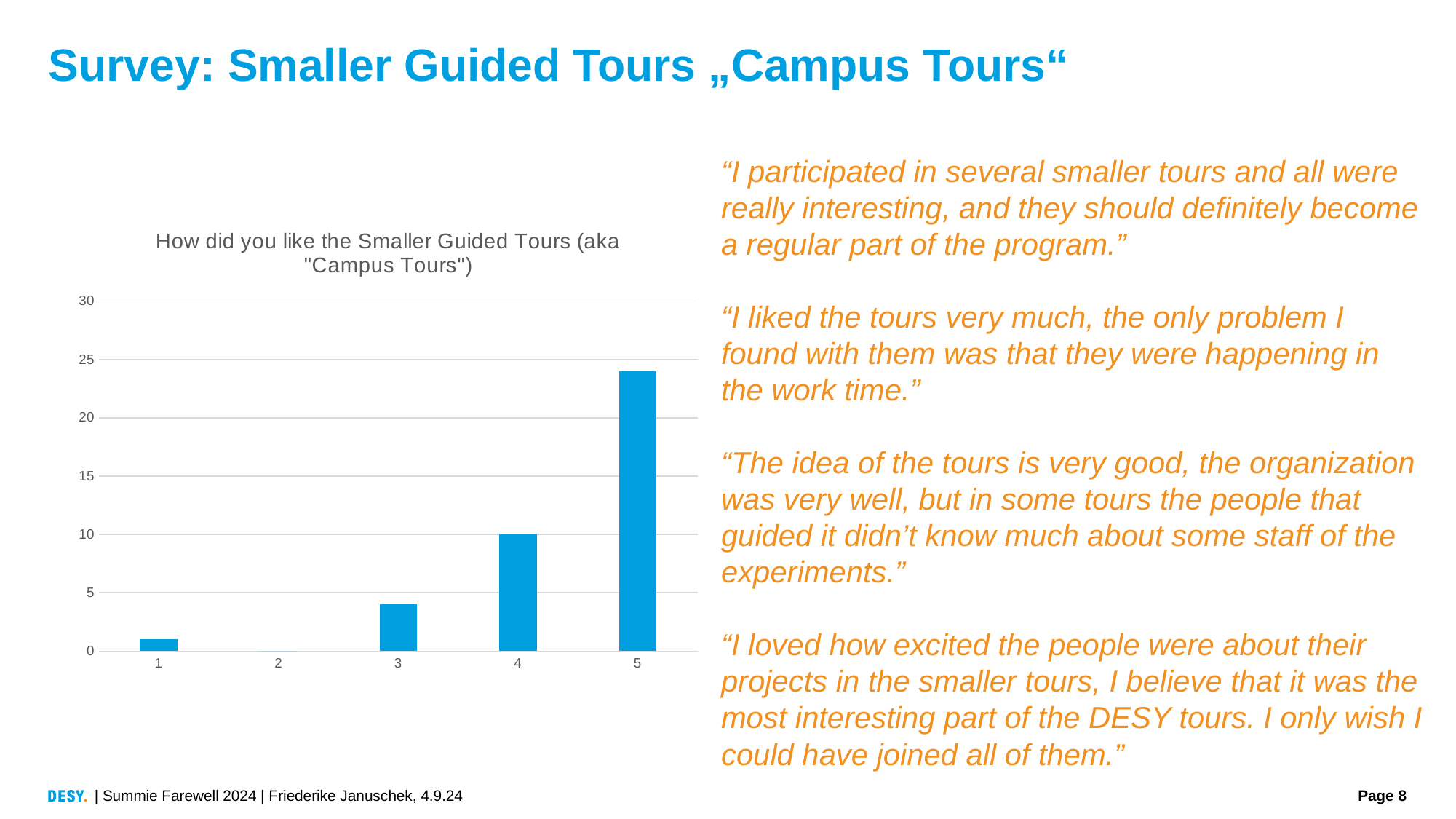
Which has a larger value, rating 1 or rating 3? 3 Do the values generally rise or fall as the rating increases from 3 to 5? rise Which rating category has the lowest value in the chart? 2 What is the value for rating 4 in the chart? 10 What is the title of the chart? How did you like the Smaller Guided Tours (aka "Campus Tours") Is the value for rating 5 greater or less than 25? less Which has a larger value, rating 4 or rating 5? 5 Is the value for rating 5 greater or less than 20? greater How many rating categories are shown on the x axis of the chart? 5 What kind of chart is shown on the slide? bar chart Is the value for rating 3 greater or less than 5? less Which rating category has the highest bar in the chart? 5